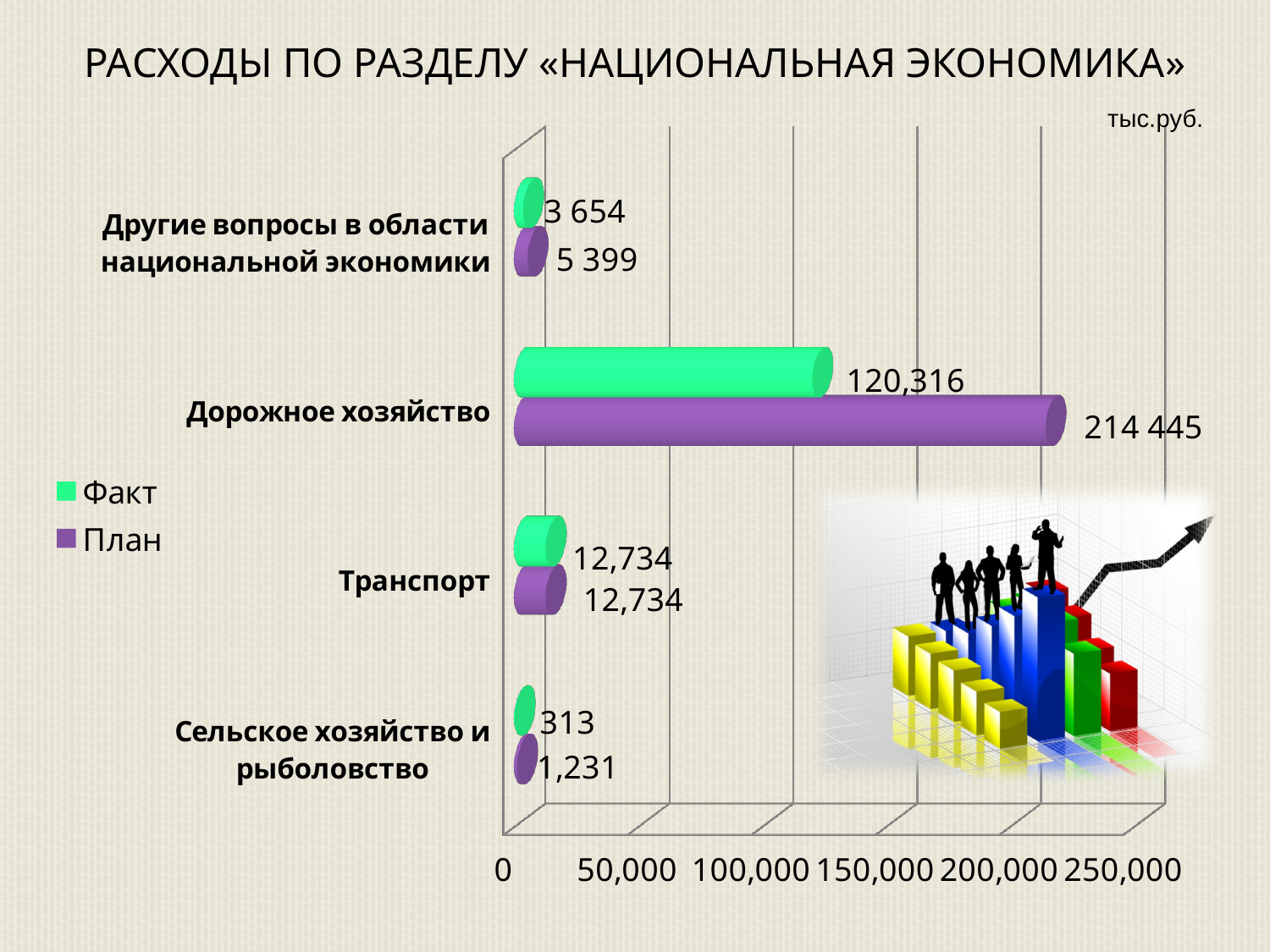
Which is larger for Другие вопросы в области национальной экономики: the Факт value or the План value? План How many series does the legend list? 2 Which category has the lowest Факт value? Сельское хозяйство и рыболовство What is the Факт value for Другие вопросы в области национальной экономики? 3 654 Which category has the highest План value? Дорожное хозяйство What is the difference between the План and Факт values for Дорожное хозяйство? 94 129 What is the План value for Сельское хозяйство и рыболовство? 1,231 What is the План value for Дорожное хозяйство? 214 445 What is the Факт value for Дорожное хозяйство? 120,316 Is the План value for Дорожное хозяйство greater or less than 200,000? greater How many categories are shown on the chart? 4 What type of chart is shown on the slide? Bar chart